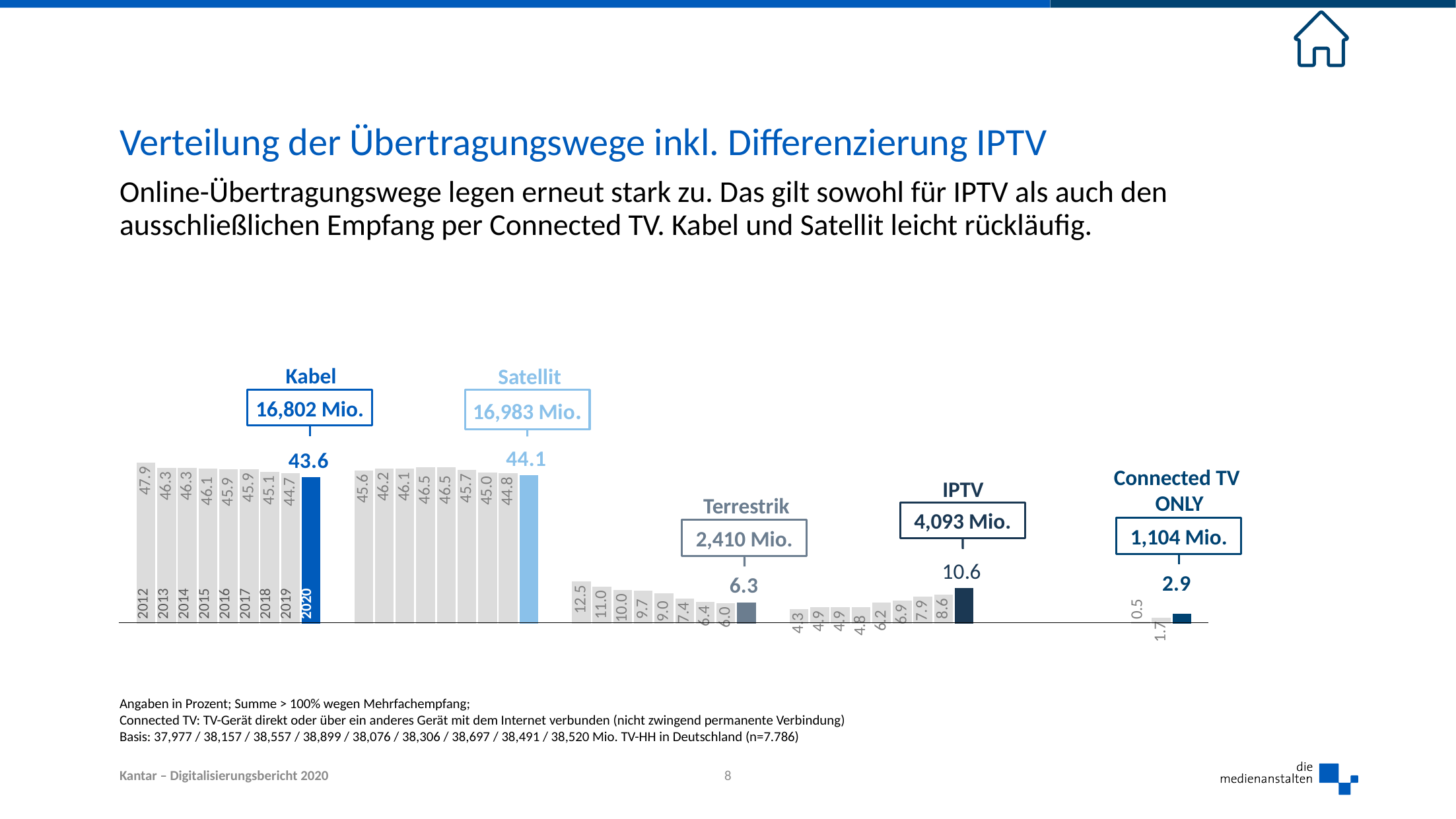
What is the value for Satellit in 2020? 44.1 What is the value for IPTV in 2020? 10.6 Which transmission path has the lowest value in 2020? Connected TV ONLY What is the value for Kabel in 2020? 43.6 Which is larger in 2020, the value for Kabel or the value for Satellit? Satellit How many bars are shown in the Kabel group? 9 What is the value for Terrestrik in 2020? 6.3 Do the IPTV values rise or fall from 2012 to 2020? rise What kind of chart is shown on the slide? bar chart What is the value for Kabel in 2012? 47.9 What is the difference between the 2020 values for Satellit and Kabel? 0.5 Which transmission path has the highest value in 2020? Satellit